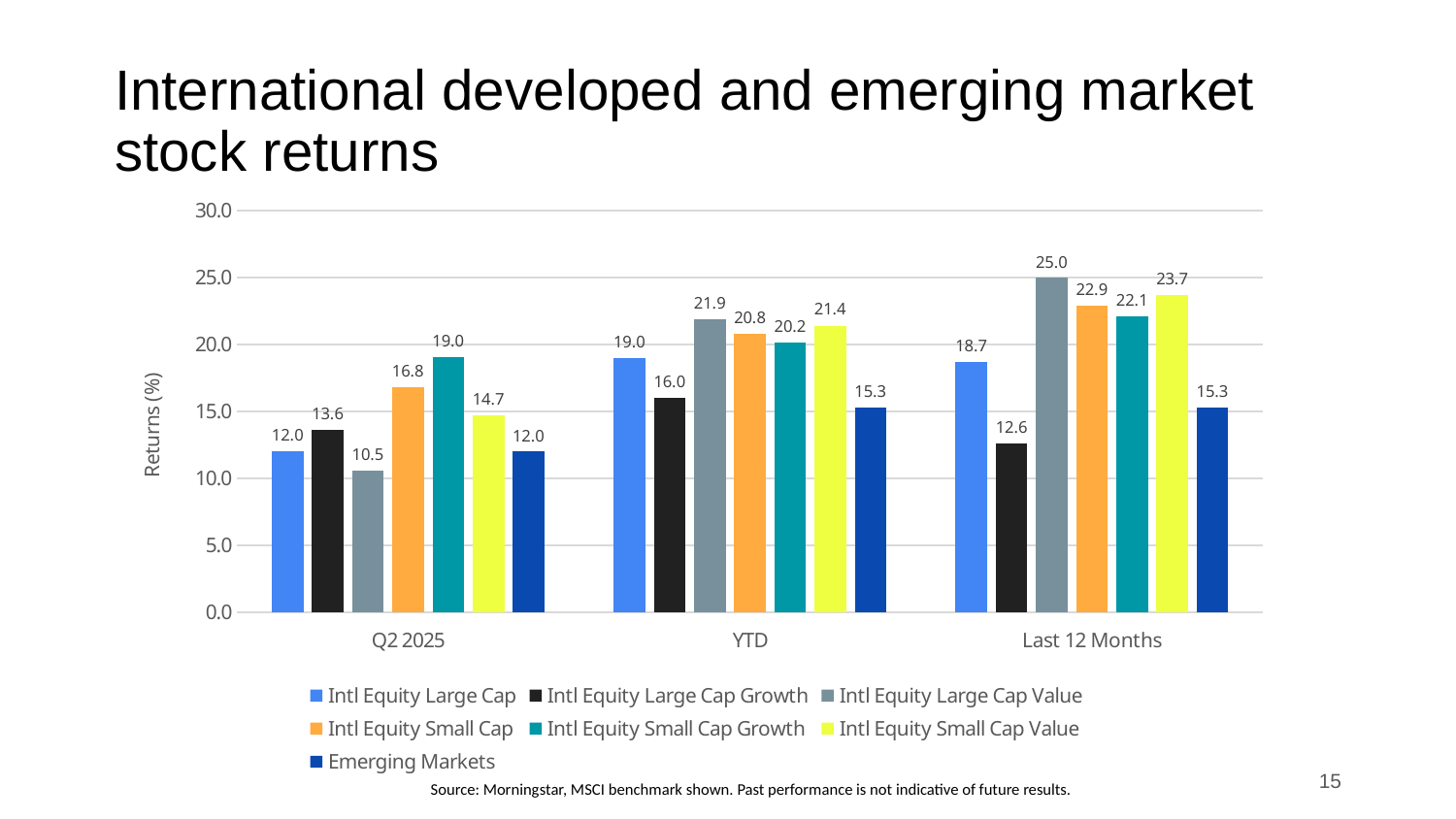
What is the difference between the Last 12 Months returns of Intl Equity Large Cap Value and Intl Equity Large Cap Growth? 12.4 What kind of chart is shown on the slide? Bar chart How many time periods are shown on the x axis? 3 What is the YTD return for Emerging Markets? 15.3 Which is larger in the YTD period: Intl Equity Small Cap or Intl Equity Small Cap Growth? Intl Equity Small Cap Which series has the highest return over the Last 12 Months? Intl Equity Large Cap Value Which series has the lowest return in Q2 2025? Intl Equity Large Cap Value How many series does the legend list? 7 What is the return for Intl Equity Large Cap Value over the Last 12 Months? 25.0 What is the label of the y axis? Returns (%) What is the return for Intl Equity Small Cap Growth in Q2 2025? 19.0 Is the Q2 2025 return for Intl Equity Small Cap greater or less than 15.0? greater